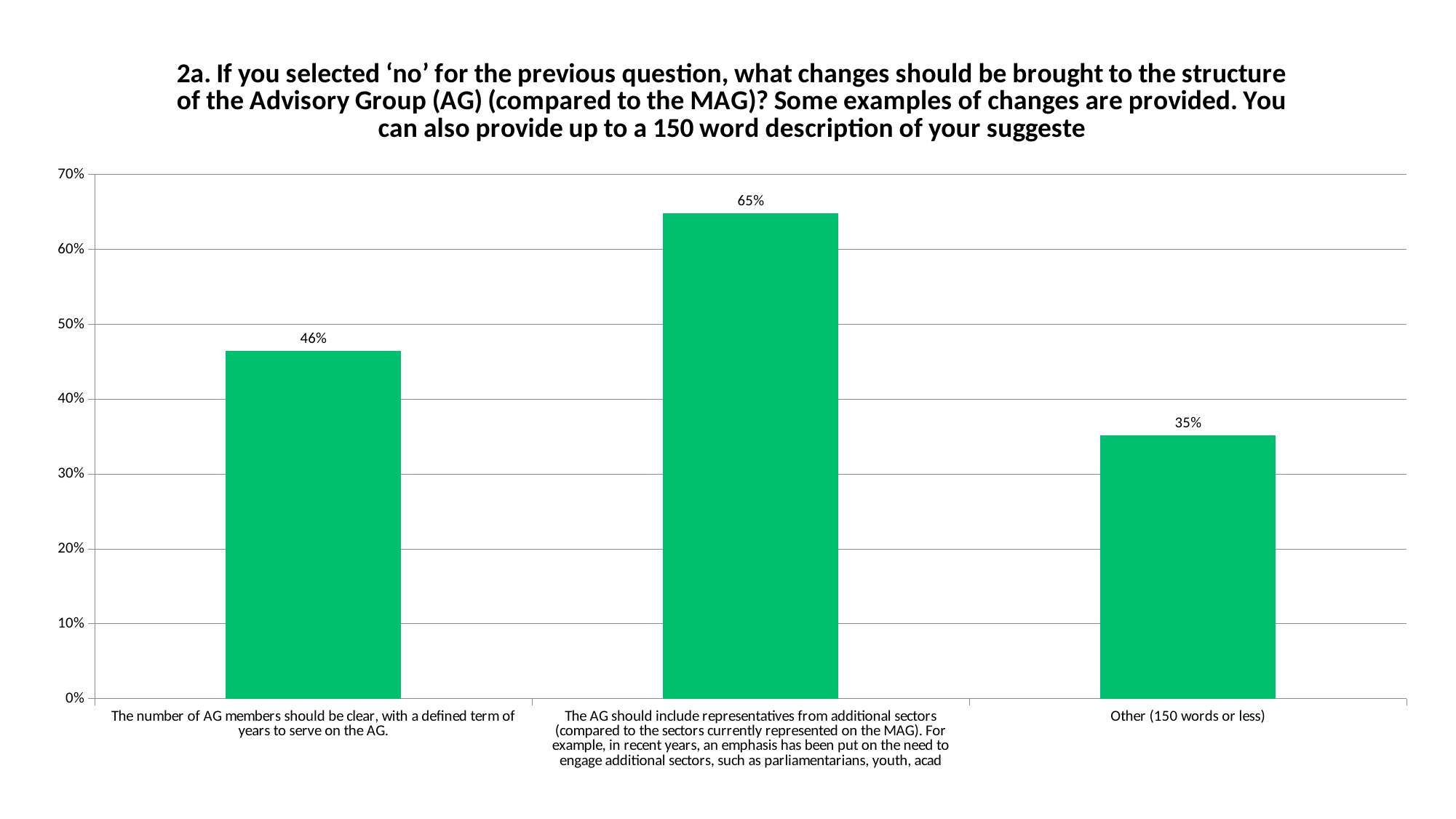
How many options (bars) are shown in the chart? 3 How much higher is the 'additional sectors' option than the 'defined term of years' option? 19% Which option has the lowest percentage? Other (150 words or less) What is the value for the option that the number of AG members should be clear, with a defined term of years to serve on the AG? 46% Which option has the highest percentage? The AG should include representatives from additional sectors What type of chart is shown on the slide? Bar chart Which is larger: the value for 'Other (150 words or less)' or the value for the 'defined term of years' option? The defined term of years option What percentage is shown for 'Other (150 words or less)'? 35% Is the value for 'Other (150 words or less)' greater or less than 40%? less What is the difference between the highest and lowest percentages shown? 30% What percentage selected that the AG should include representatives from additional sectors? 65% What is the maximum value shown on the vertical axis? 70%